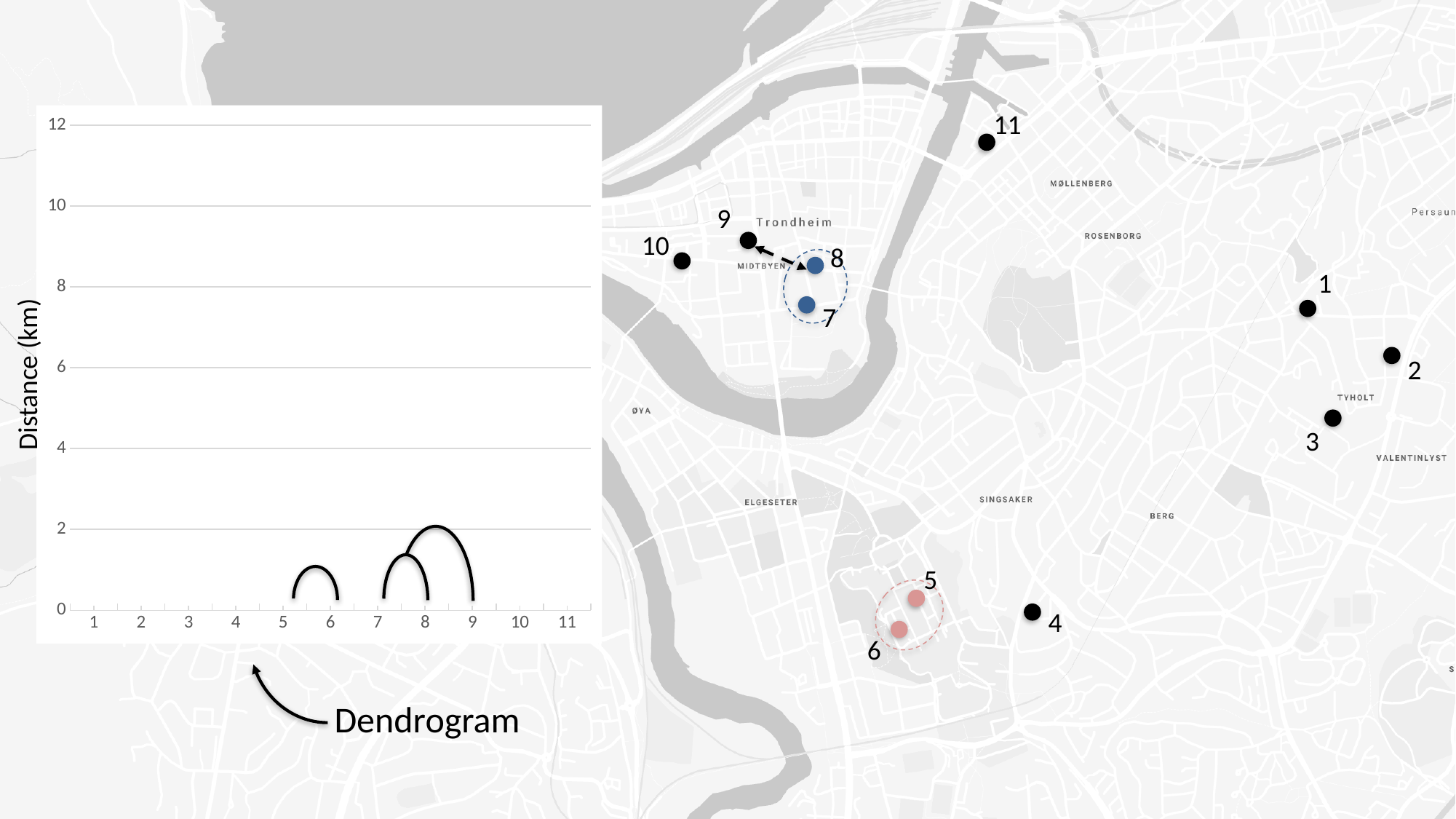
In the dendrogram, which point is joined to the cluster of 7 and 8? 9 What is the label of the y axis of the dendrogram? Distance (km) In the dendrogram, which is joined at a greater height: the link between 5 and 6, or the link joining 9 to the cluster of 7 and 8? the link joining 9 to the cluster of 7 and 8 In the dendrogram, is the height at which points 7 and 8 are joined greater or less than 2? less In the dendrogram, is the height at which point 9 joins the cluster of 7 and 8 greater or less than 4? less In the dendrogram, which pair of points is joined at the lowest height? 5 and 6 In the dendrogram, are any of the points 1 to 4 joined by an arc? No What is the highest value shown on the y axis of the dendrogram? 12 How many numbered points are listed along the x axis of the dendrogram? 11 What kind of chart is shown on the left of the slide? Dendrogram In the dendrogram, is the height at which points 5 and 6 are joined greater or less than 2? less